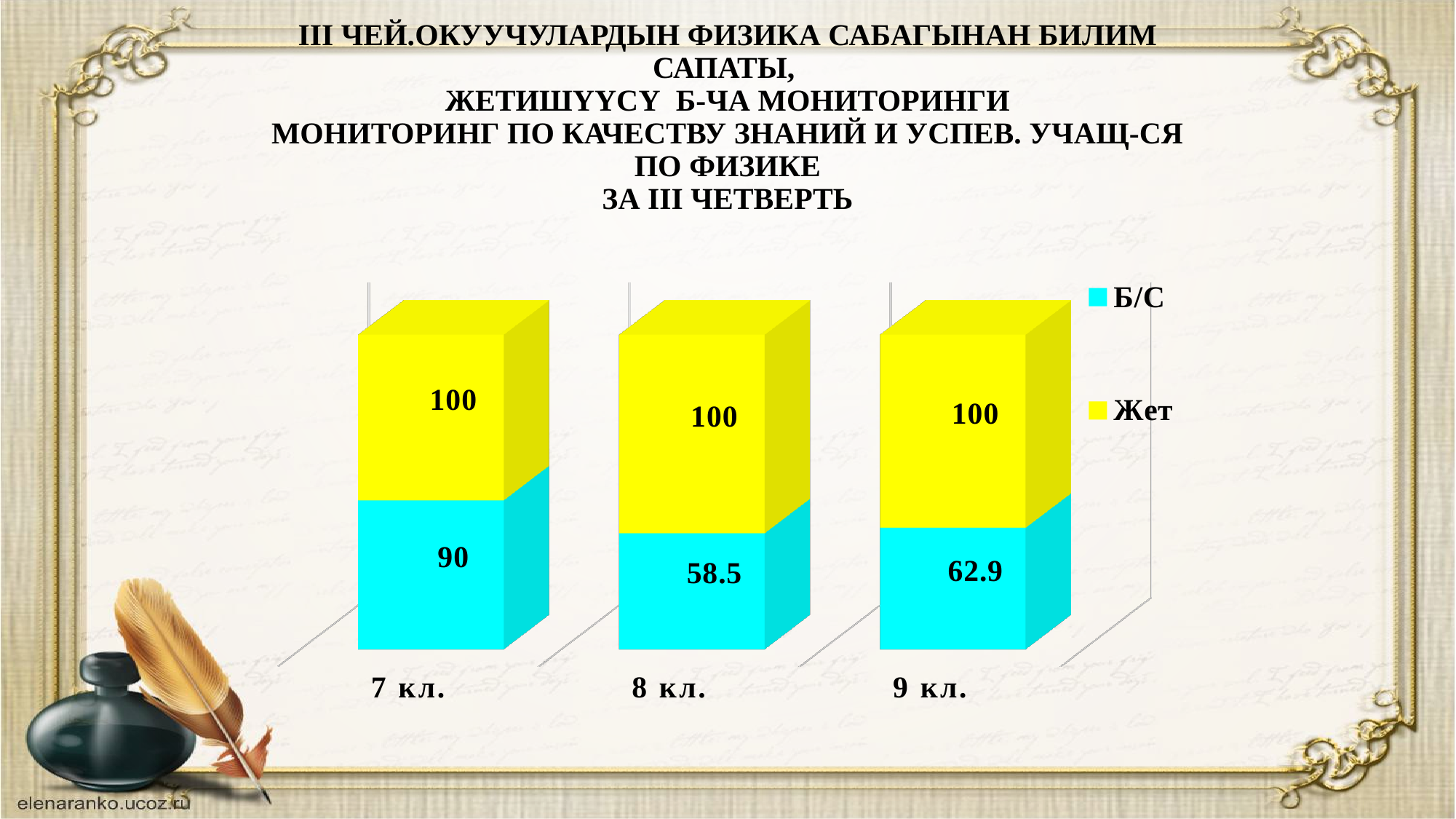
Which class has the lowest Б/С value? 8 кл. What is the Жет value for 8 кл.? 100 What is the difference between the Б/С values for 7 кл. and 8 кл.? 31.5 What kind of chart is shown on the slide? Stacked bar chart How many classes are shown on the x axis? 3 What is the Б/С value for 9 кл.? 62.9 Which class has the highest Б/С value? 7 кл. What is the Б/С value for 8 кл.? 58.5 What is the total of the stacked bar for 9 кл.? 162.9 How many series does the legend list? 2 What is the Б/С value for 7 кл.? 90 Which is larger, the Б/С value for 9 кл. or for 8 кл.? 9 кл.